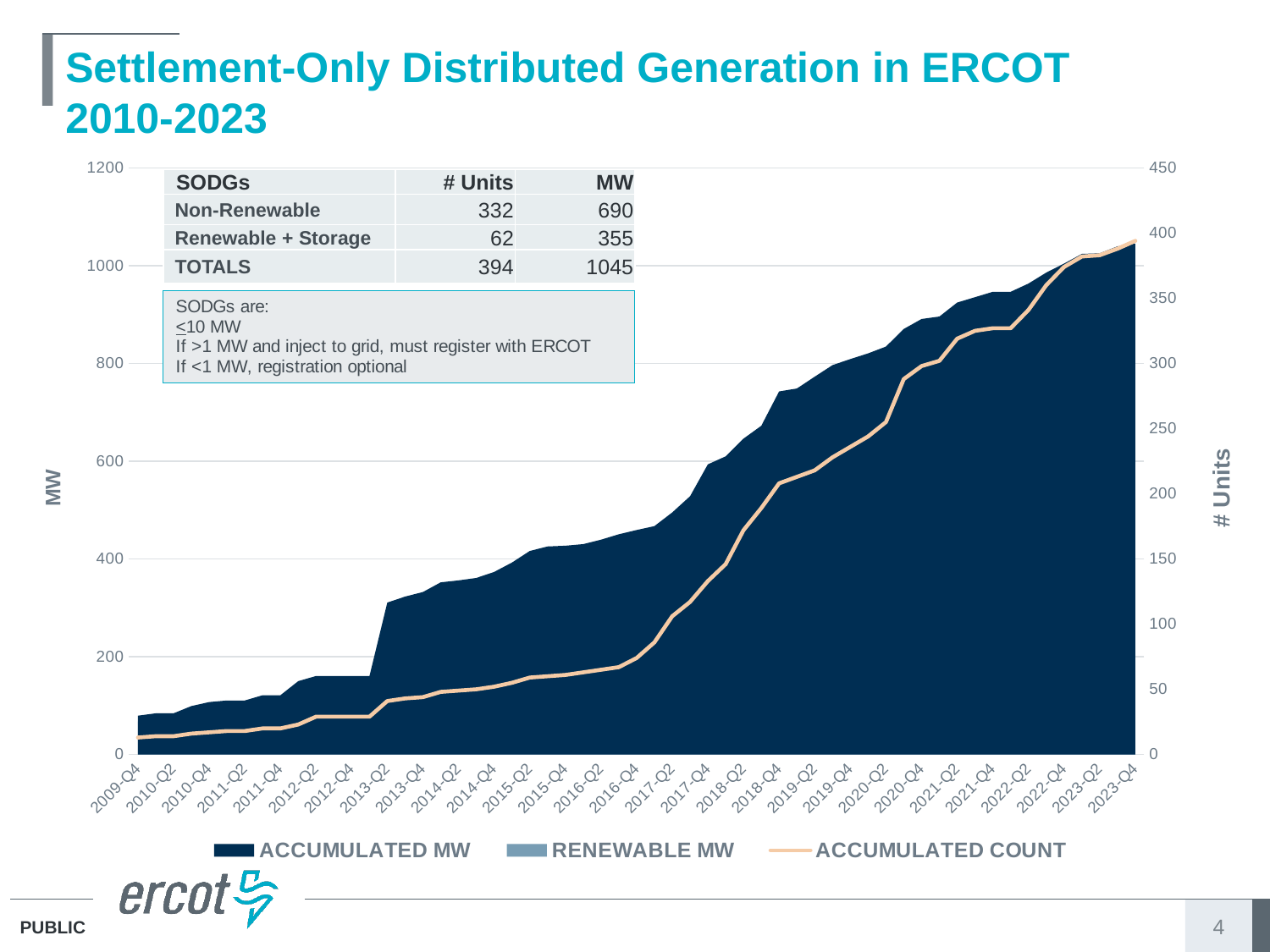
What is the title of the left vertical axis of the chart? MW Is the ACCUMULATED MW value at 2013-Q2 greater or less than 400? less What kind of chart is shown on the slide? Area chart with a line According to the table on the chart, how many MW do Non-Renewable SODGs account for? 690 Does the ACCUMULATED MW series rise or fall from 2009-Q4 to 2023-Q4? Rise What are the three series named in the chart legend? ACCUMULATED MW, RENEWABLE MW, ACCUMULATED COUNT Is the ACCUMULATED COUNT value at 2016-Q4 greater or less than 100 units? less How many series does the chart legend list? 3 Is the ACCUMULATED MW value at 2010-Q2 greater or less than 200? less According to the table on the chart, what is the total number of SODG units? 394